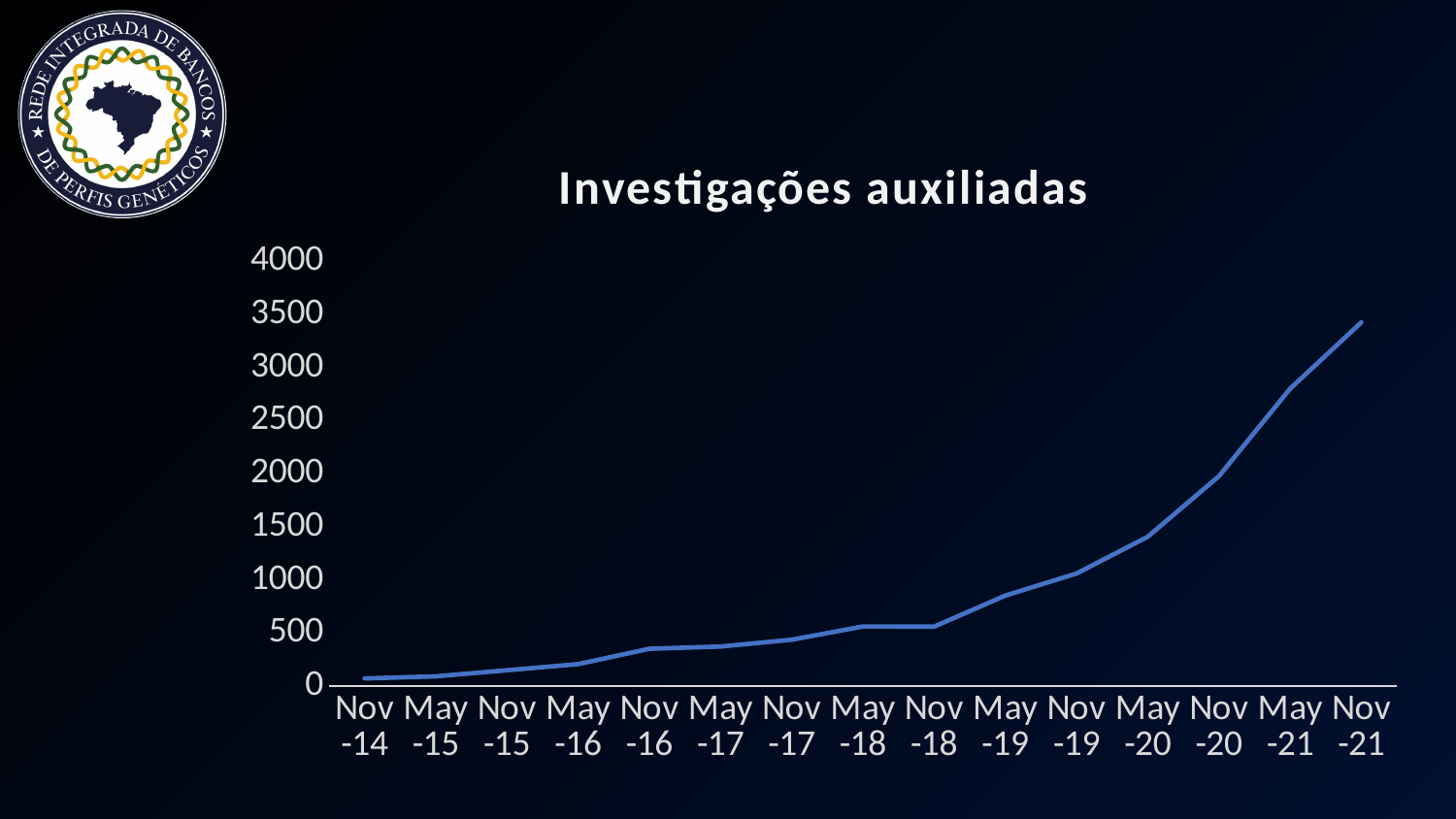
What is the title of the chart? Investigações auxiliadas Is the value for May-19 greater or less than 1000? less Do the values rise or fall from Nov-14 to Nov-21? rise Is the value for May-21 greater or less than 2500? greater What kind of chart is shown on the slide? line chart Which point on the x axis has the highest value? Nov-21 Is the value for Nov-20 greater or less than 1500? greater Which point on the x axis has the lowest value? Nov-14 Which is larger, the value for May-20 or the value for May-21? May-21 How many data points are plotted along the x axis? 15